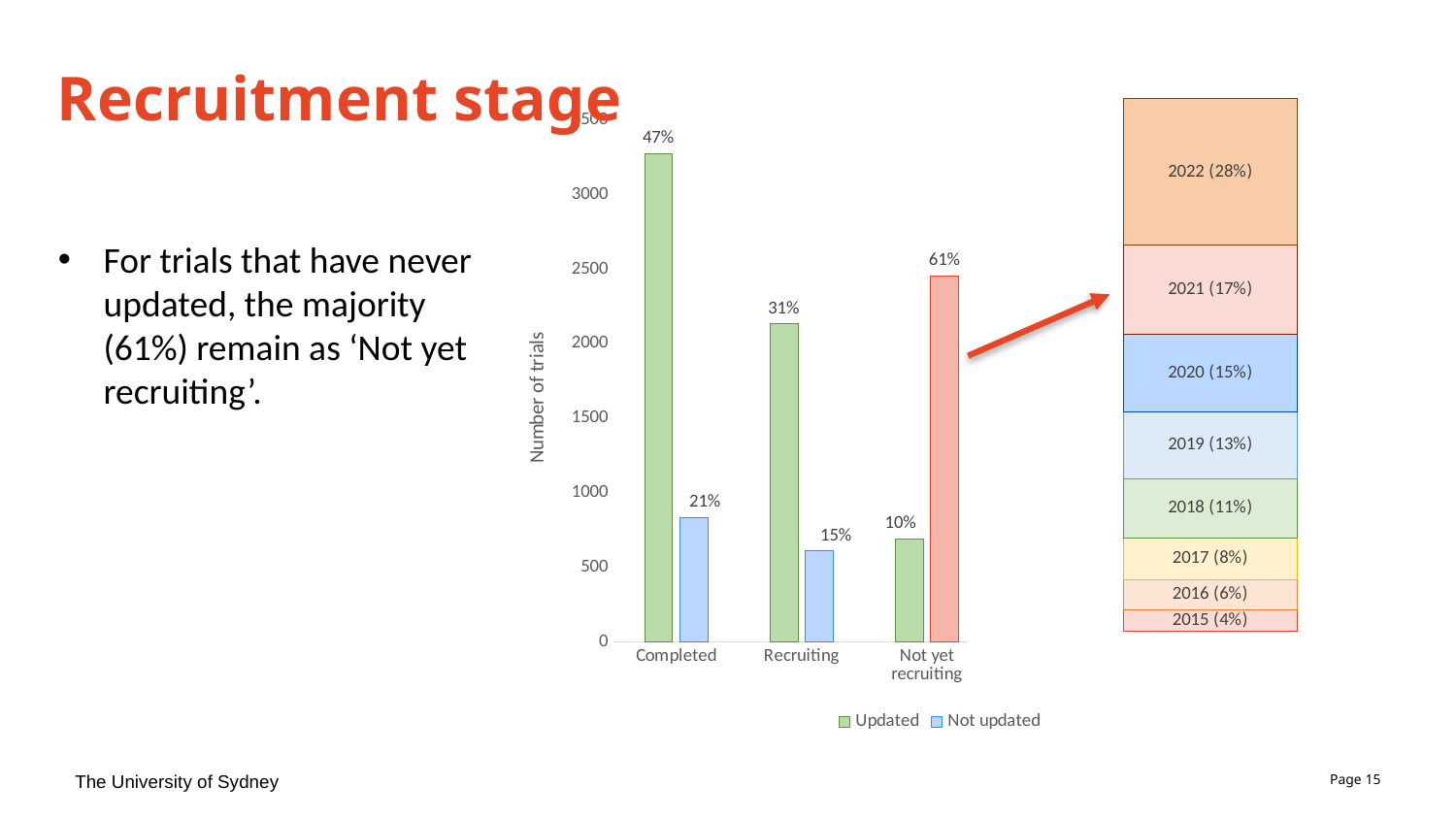
In the bar chart, what is the difference between the percentage labels on the Not updated and Updated bars for Not yet recruiting? 51% How many series does the bar chart's legend list? 2 In the bar chart, what percentage label is shown on the Not updated bar for Not yet recruiting? 61% In the bar chart, what percentage label is shown on the Updated bar for Completed? 47% In the bar chart, what percentage label is shown on the Updated bar for Not yet recruiting? 10% In the bar chart, which category has the shortest Not updated bar? Recruiting What kind of chart is the main chart on the slide? bar chart In the bar chart, is the number of trials for the Not updated bar in Completed greater or less than 1000? less In the bar chart, what percentage label is shown on the Not updated bar for Recruiting? 15% In the stacked bar on the right, what percentage is shown for 2022? 28% In the bar chart, which category has the tallest Updated bar? Completed In the bar chart, is the number of trials for the Updated bar in Completed greater or less than 3000? greater